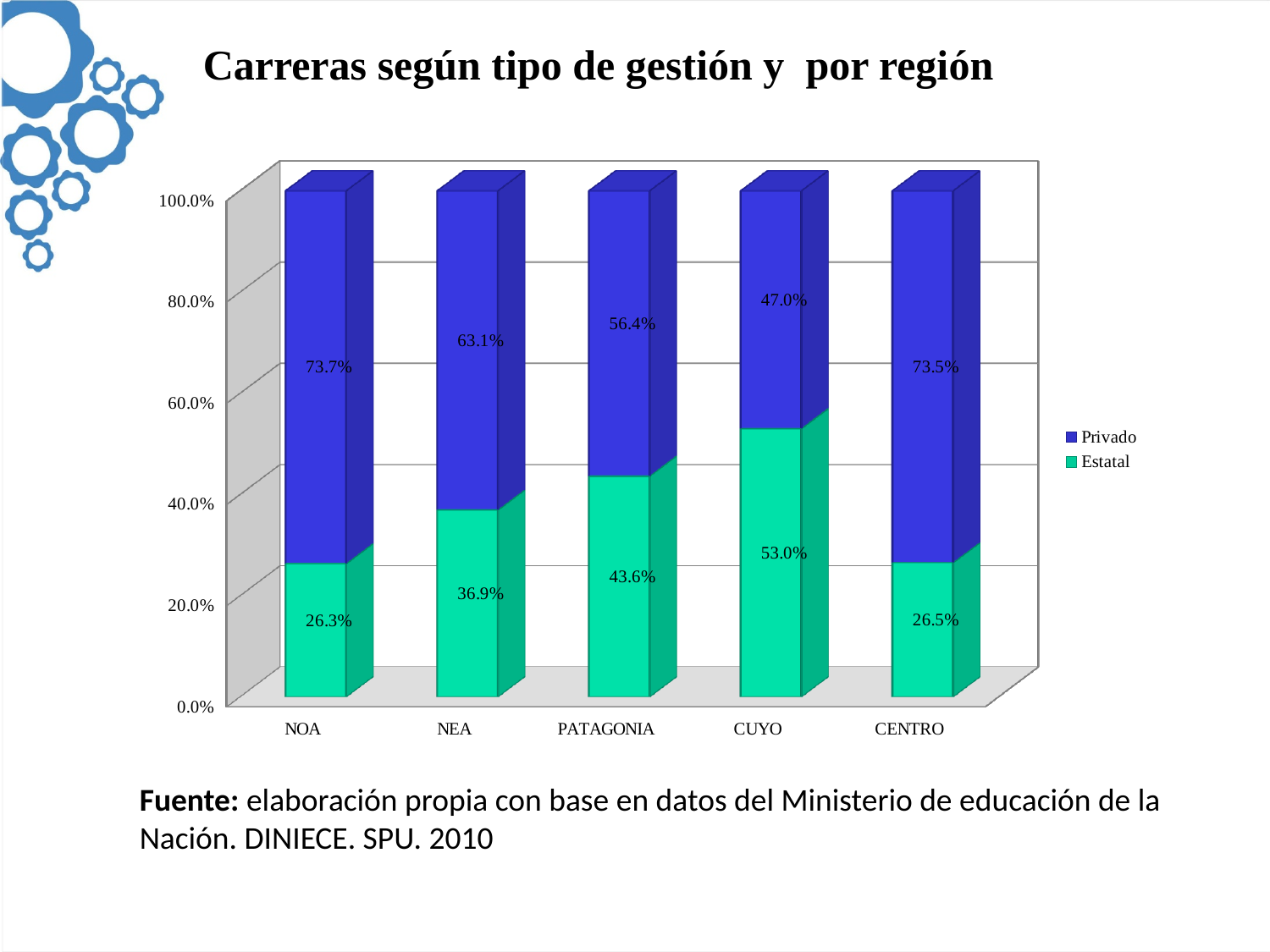
What kind of chart is shown on the slide? Stacked bar chart What is the Privado value for CENTRO? 73.5% How many series does the legend list? 2 What is the Privado value for NOA? 73.7% Which region has the lowest Privado share? CUYO What is the difference between the Privado and Estatal values for NEA? 26.2% Which region has the highest Estatal share? CUYO What is the Estatal value for PATAGONIA? 43.6% How many regions are shown on the x axis? 5 What is the title of the chart? Carreras según tipo de gestión y por región What is the Estatal value for CUYO? 53.0% Which is larger for PATAGONIA, the Privado value or the Estatal value? Privado